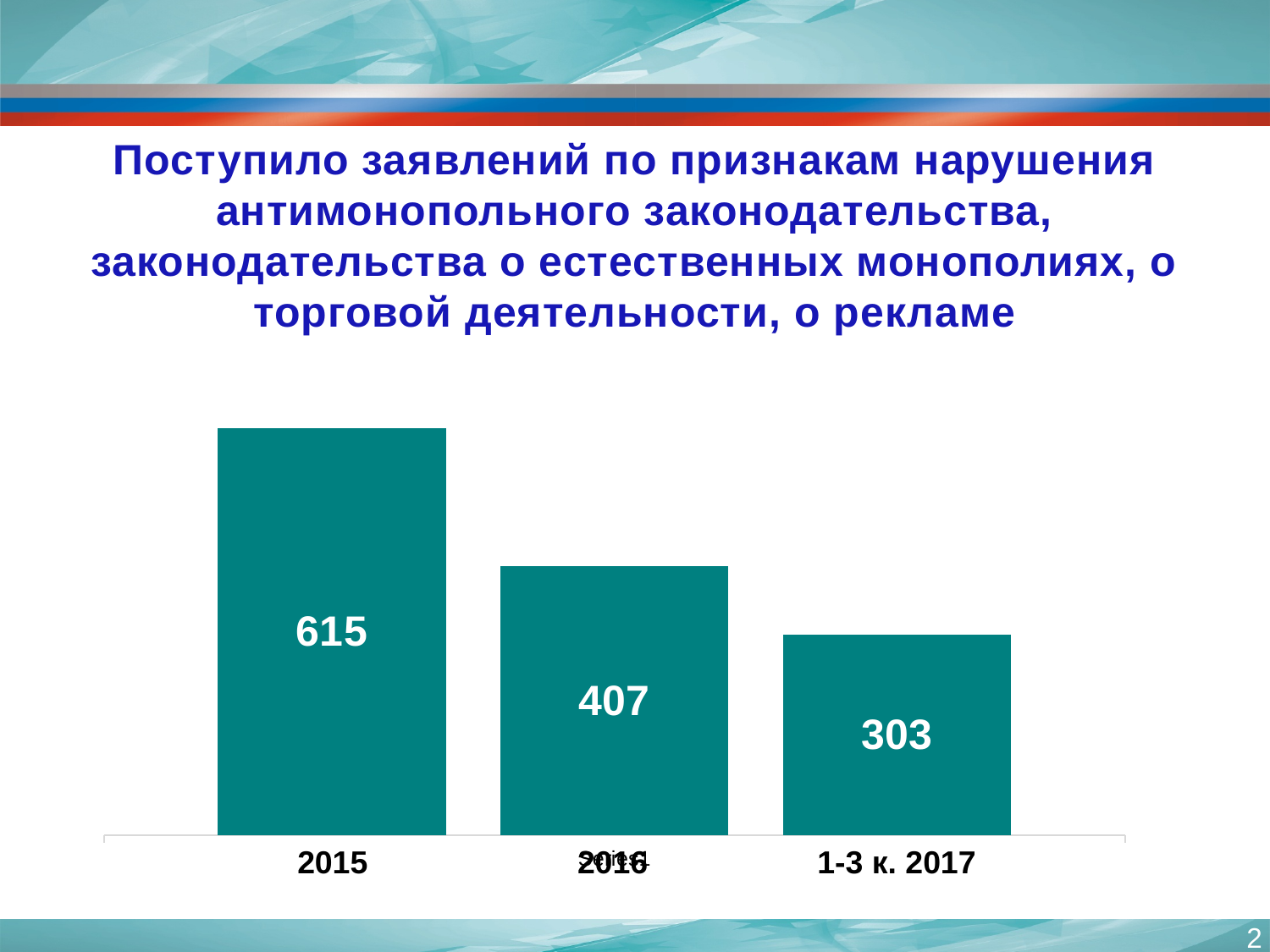
Do the values rise or fall from 2015 to 1-3 к. 2017? fall What is the difference between the values for 2016 and 1-3 к. 2017? 104 What colour are the bars in the chart? teal What is the value for 1-3 к. 2017? 303 How many bars are shown in the chart? 3 Which is larger, the value for 2015 or the value for 1-3 к. 2017? 2015 What is the value for 2016? 407 What is the difference between the values for 2015 and 2016? 208 What kind of chart is shown on the slide? bar chart What is the value for 2015? 615 Which category has the highest value? 2015 Which category has the lowest value? 1-3 к. 2017